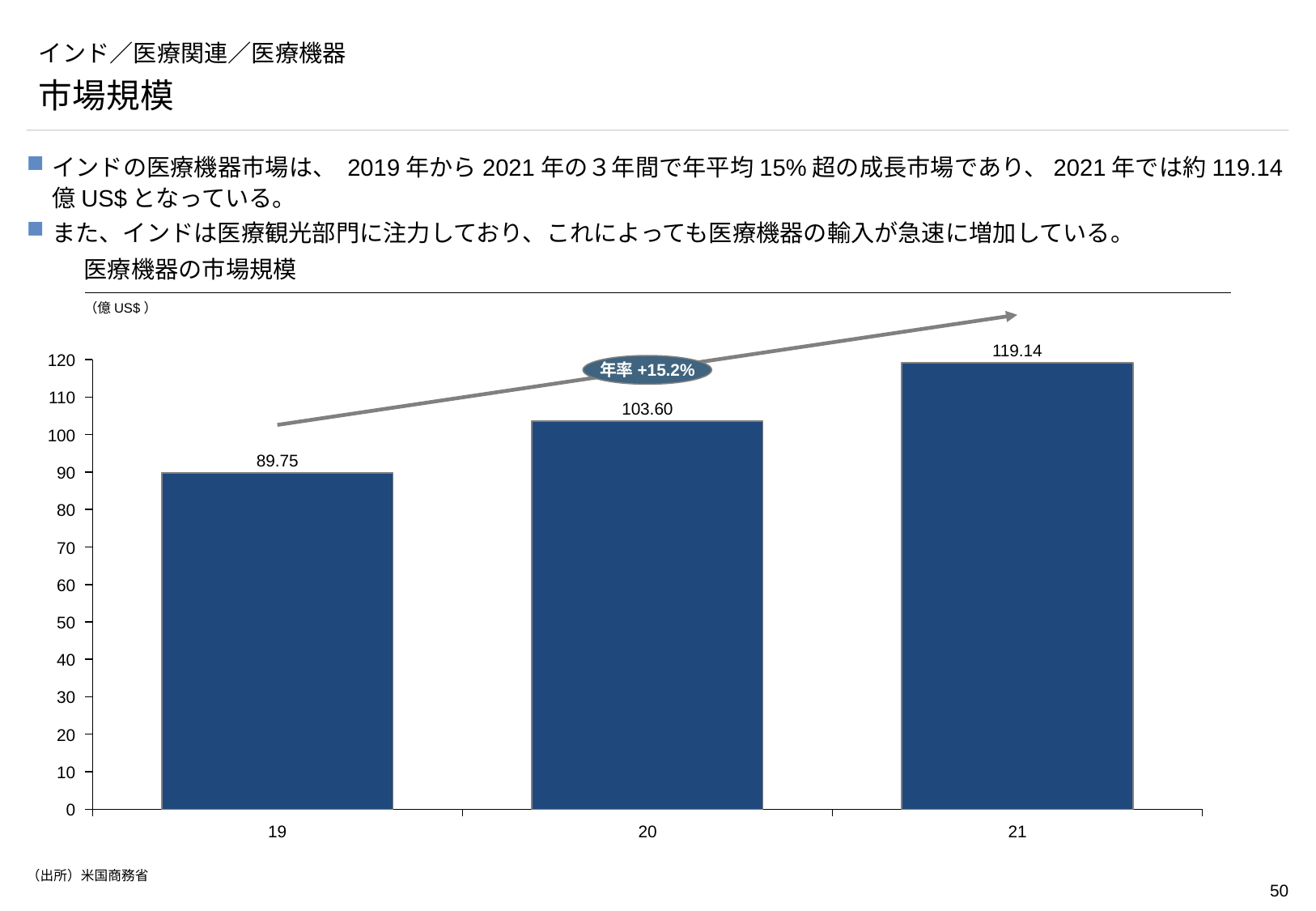
What is the difference between the values for 21 and 19? 29.39 What is the value for 21 in the chart? 119.14 Do the values rise or fall from 19 to 21? rise What kind of chart is shown? bar chart What is the value for 19 in the chart? 89.75 Is the value for 19 greater or less than 100? less What is the difference between the values for 20 and 19? 13.85 How many bars are in the chart? 3 Which category has the highest value? 21 Which is larger, the value for 20 or the value for 21? 21 Which category has the lowest value? 19 What is the value for 20 in the chart? 103.60